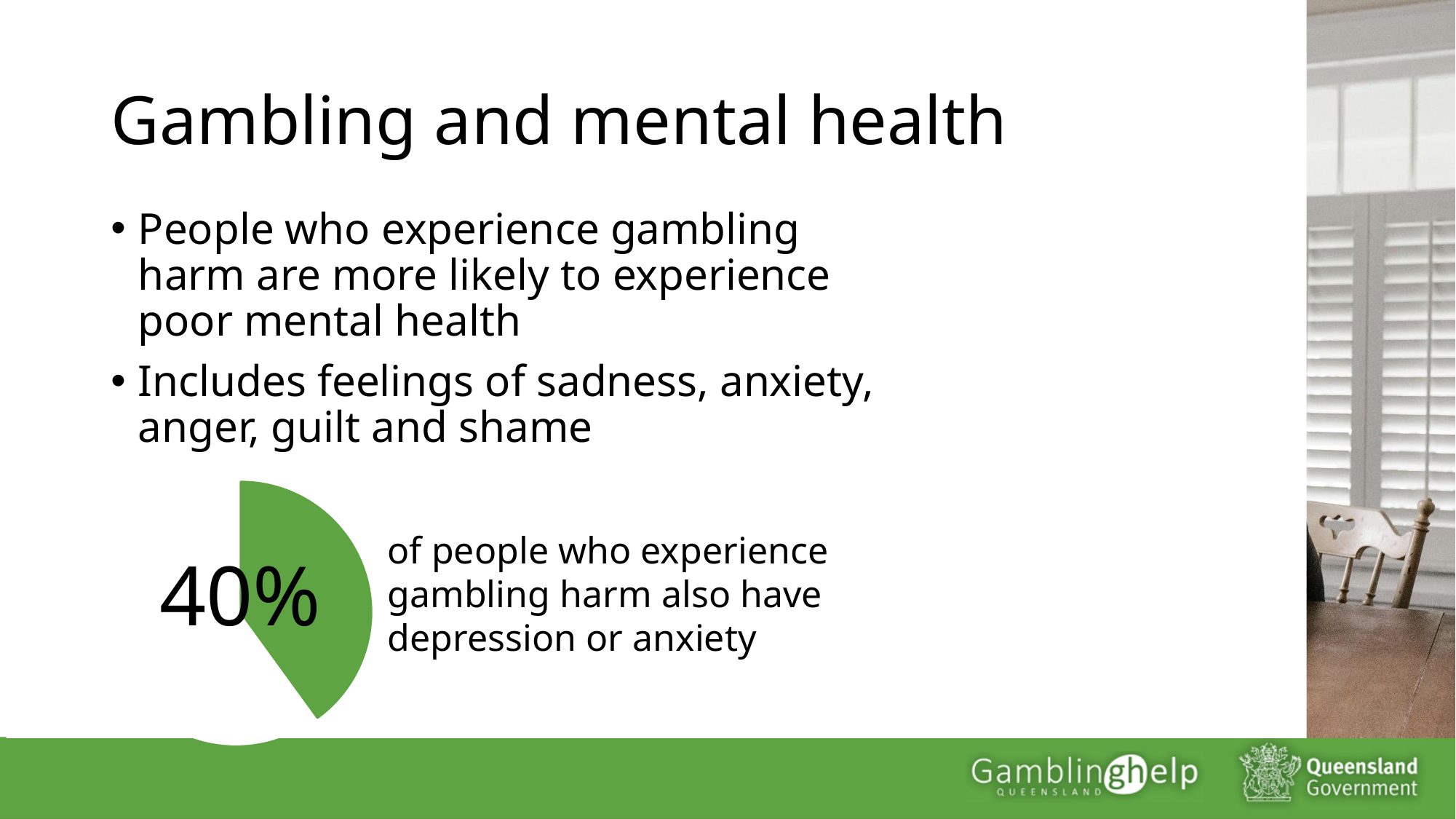
Is the value shown by the green slice greater or less than 50%? less What colour is the highlighted slice of the pie chart? green What is the title of the slide containing the pie chart? Gambling and mental health What percentage of people who experience gambling harm also have depression or anxiety, according to the chart? 40% What kind of chart is shown on the slide? pie chart What share of the pie does the green slice represent? 40%